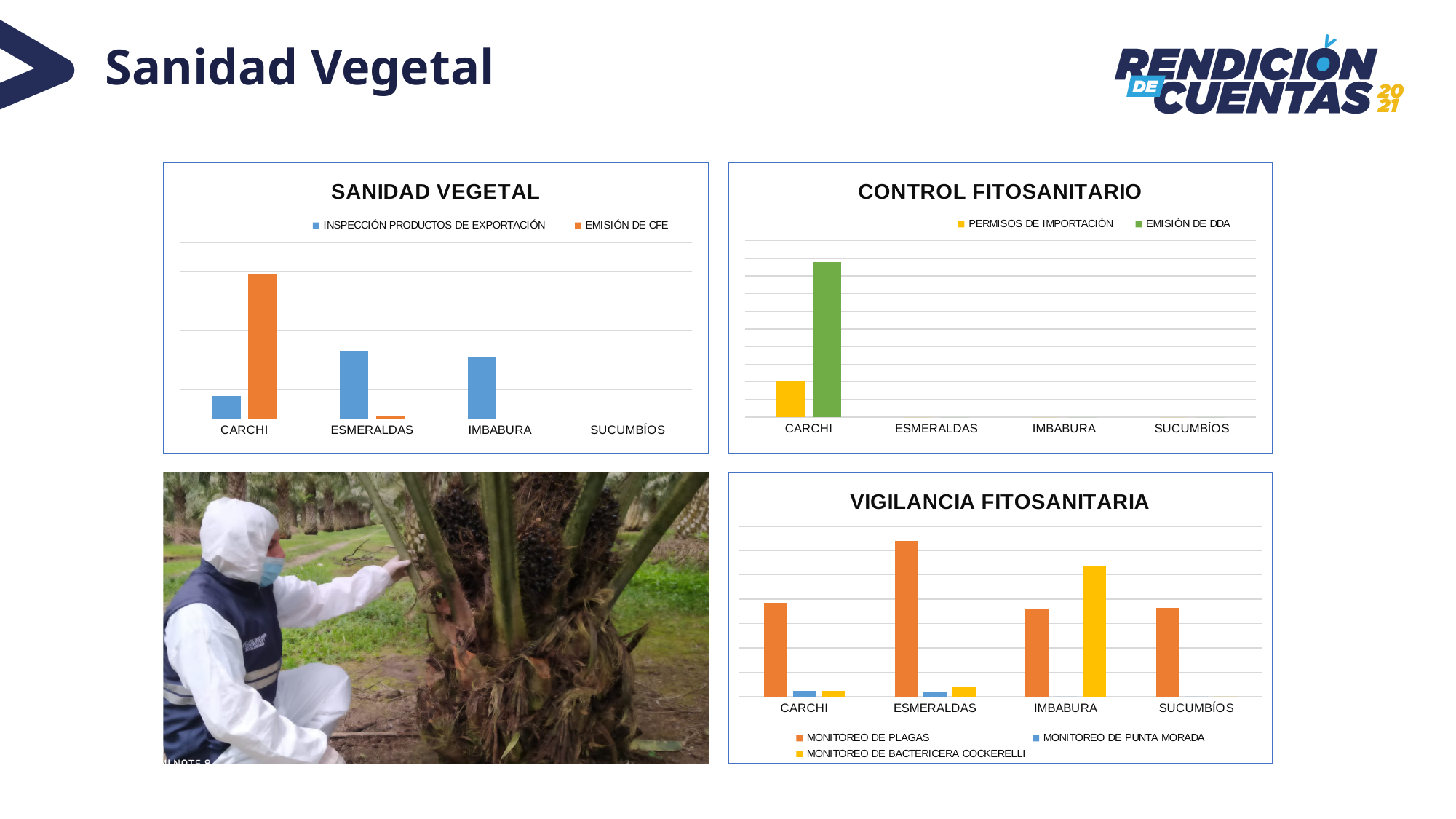
In the SANIDAD VEGETAL chart, which province has the highest value for EMISIÓN DE CFE? CARCHI In the CONTROL FITOSANITARIO chart, is the value for PERMISOS DE IMPORTACIÓN or EMISIÓN DE DDA larger for CARCHI? EMISIÓN DE DDA In the VIGILANCIA FITOSANITARIA chart, how many series does the legend list? 3 In the VIGILANCIA FITOSANITARIA chart, which province has the highest value for MONITOREO DE PLAGAS? ESMERALDAS What type of chart is the SANIDAD VEGETAL chart? bar chart In the VIGILANCIA FITOSANITARIA chart, which province has the highest value for MONITOREO DE BACTERICERA COCKERELLI? IMBABURA In the VIGILANCIA FITOSANITARIA chart, is the value for MONITOREO DE PLAGAS or MONITOREO DE BACTERICERA COCKERELLI larger for IMBABURA? MONITOREO DE BACTERICERA COCKERELLI In the SANIDAD VEGETAL chart, is the value for INSPECCIÓN PRODUCTOS DE EXPORTACIÓN or EMISIÓN DE CFE larger for CARCHI? EMISIÓN DE CFE In the SANIDAD VEGETAL chart, how many series does the legend list? 2 In the SANIDAD VEGETAL chart, how many provinces are shown on the x axis? 4 In the CONTROL FITOSANITARIO chart, which series is shown in green? EMISIÓN DE DDA